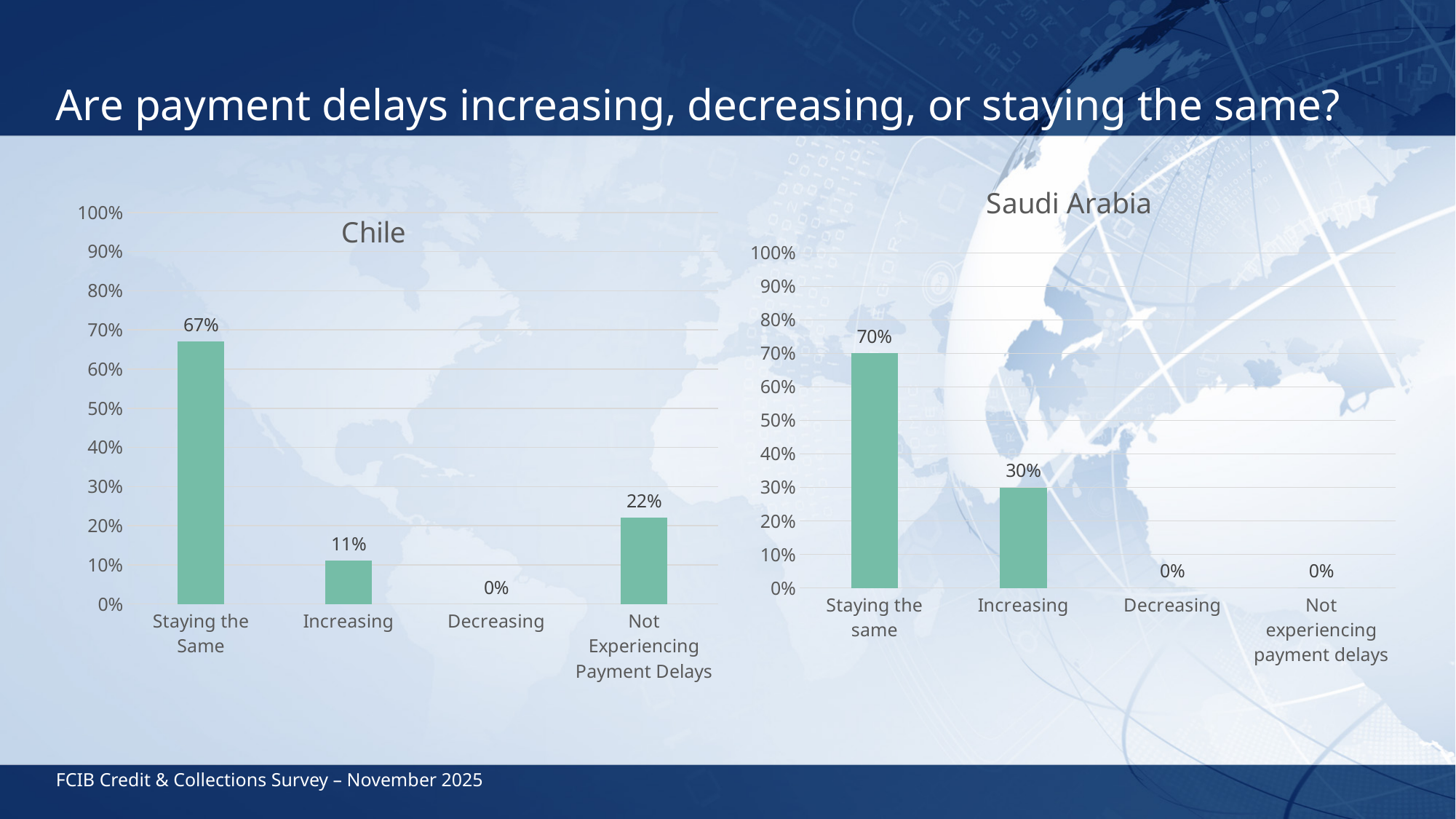
In the Saudi Arabia chart, which category has the highest value? Staying the same How many categories does the Saudi Arabia chart show? 4 In the Chile chart, what is the difference between Staying the Same and Increasing? 56% In the Chile chart, what is the value for Not Experiencing Payment Delays? 22% In the Chile chart, which category has the highest value? Staying the Same In the Chile chart, what is the value for Staying the Same? 67% Which is larger: Increasing in the Chile chart or Increasing in the Saudi Arabia chart? Saudi Arabia In the Saudi Arabia chart, what is the difference between Staying the same and Increasing? 40% What kind of chart is the Chile chart? Bar chart In the Saudi Arabia chart, what is the value for Decreasing? 0% In the Saudi Arabia chart, what is the value for Increasing? 30% In the Chile chart, is the value for Not Experiencing Payment Delays greater or less than 30%? less